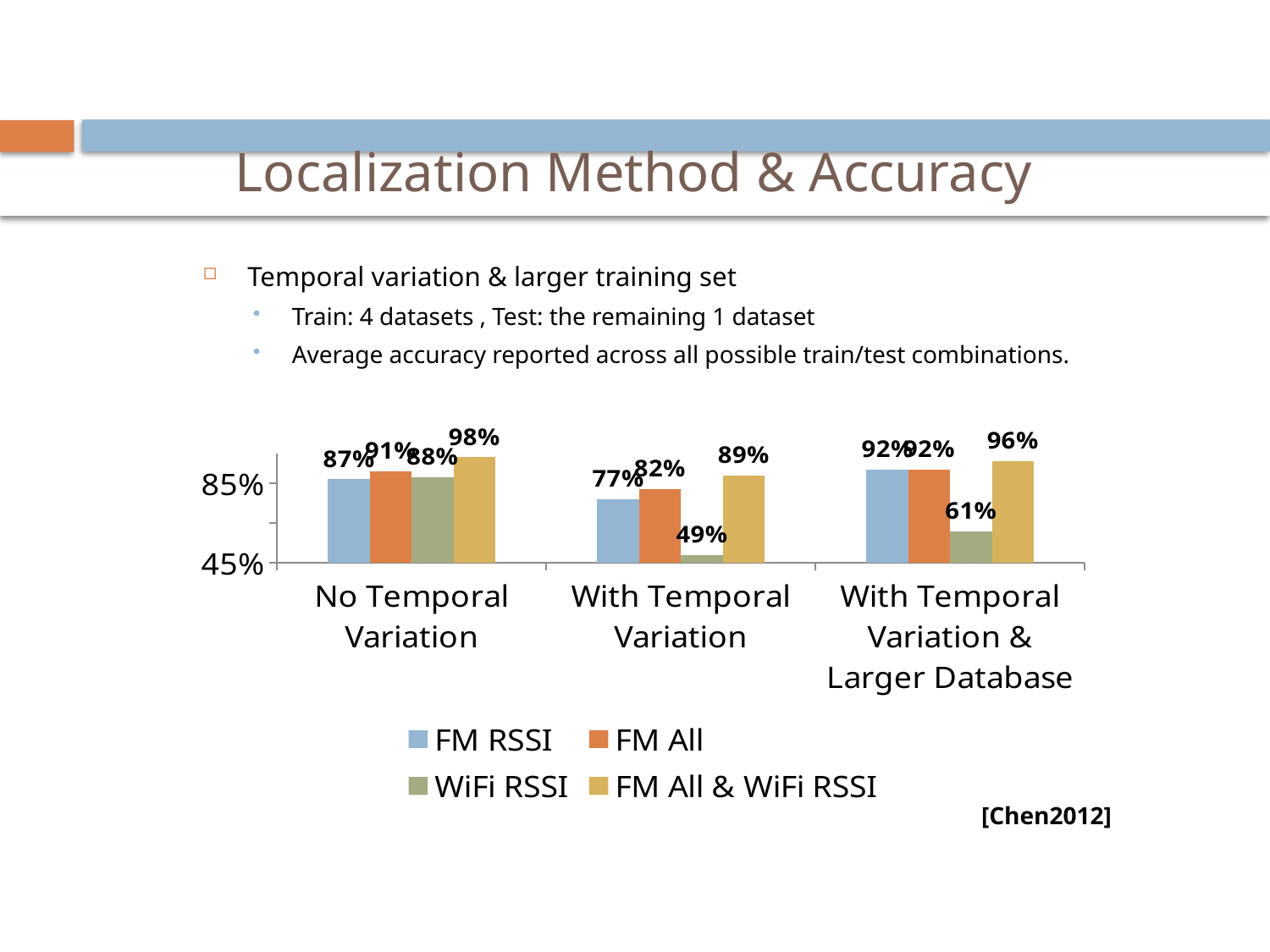
Which is larger: the FM RSSI value under No Temporal Variation or the FM RSSI value under With Temporal Variation? No Temporal Variation Which series has the lowest value under With Temporal Variation? WiFi RSSI How many categories are shown on the x axis? 3 What type of chart is shown on the slide? bar chart How many series does the legend list? 4 What is the value for FM All & WiFi RSSI under With Temporal Variation & Larger Database? 96% What is the value for WiFi RSSI under With Temporal Variation? 49% What is the value for WiFi RSSI under With Temporal Variation & Larger Database? 61% Which series is shown in orange in the legend? FM All What is the difference between the FM All & WiFi RSSI value and the WiFi RSSI value under With Temporal Variation? 40% What is the value for FM All & WiFi RSSI under No Temporal Variation? 98% Which series has the highest value under No Temporal Variation? FM All & WiFi RSSI